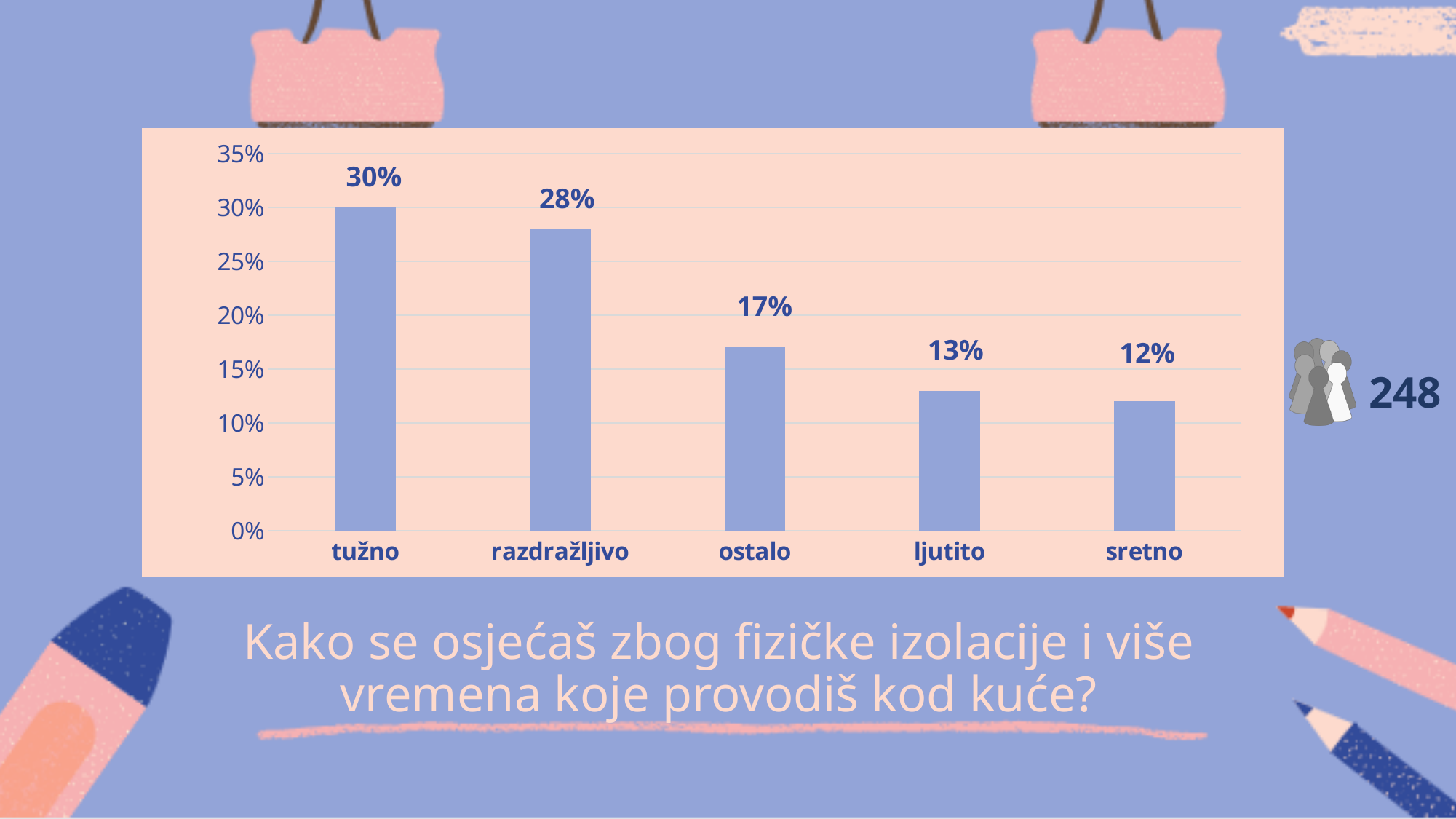
What is the value for ostalo? 17% How many categories are shown in the chart? 5 Which is larger, the value for ostalo or the value for ljutito? ostalo What is the value for sretno? 12% What kind of chart is shown on the slide? bar chart Do the values rise or fall from left to right along the x axis? fall What is the difference between the values for razdražljivo and ostalo? 11% Which category has the highest value? tužno What is the value for razdražljivo? 28% What is the difference between the values for tužno and ljutito? 17% What is the value for tužno? 30% Which category has the lowest value? sretno